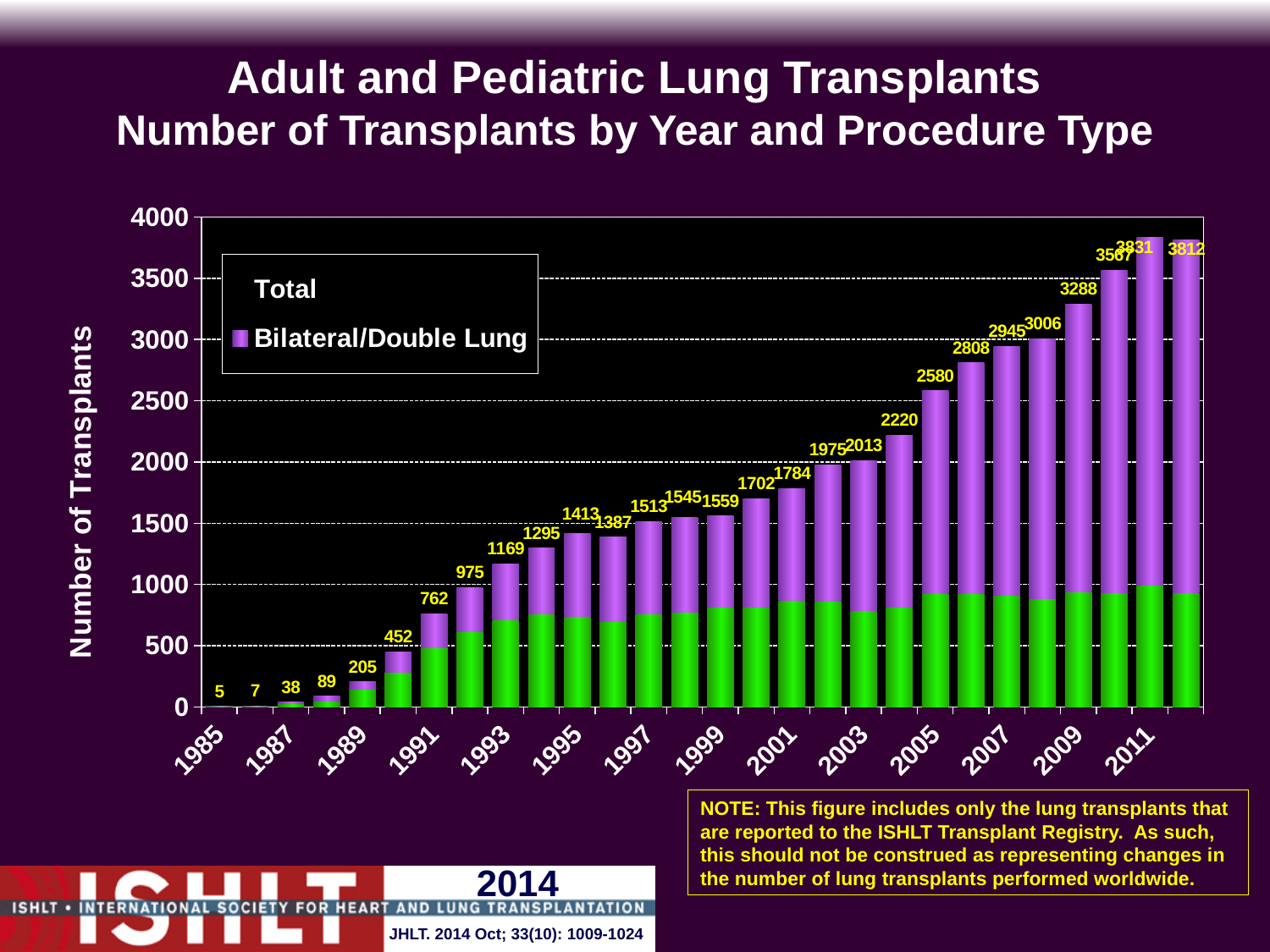
Which year has the lowest total number of transplants? 1985 Do the total transplant numbers generally rise or fall from 1985 to 2011? Rise What is the difference between the total for 2012 and the total for 2011? 19 Which year has a larger total, 1995 or 1996? 1995 What is the total number of lung transplants shown for 2005? 2580 Is the bilateral/double lung value for 2012 greater or less than 1000? greater Which year has the highest total number of transplants? 2011 What is the difference between the total for 2000 and the total for 1990? 1250 What kind of chart is shown on the slide? Stacked bar chart What is the total number of lung transplants shown for 1991? 762 What is the total number of lung transplants shown for 2009? 3288 How many years are plotted on the x axis? 28